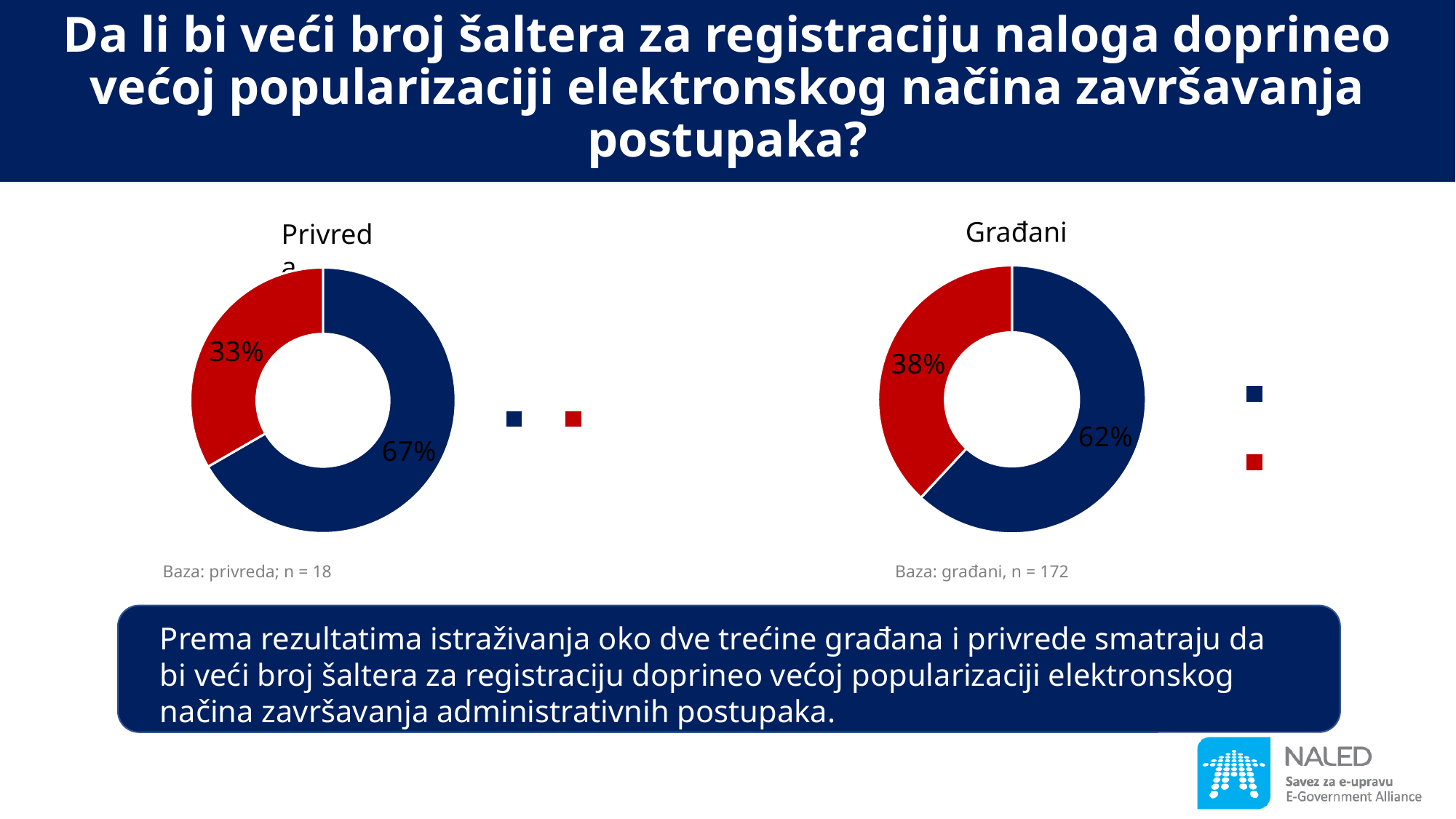
In the Privreda chart, which colour slice is the largest? dark blue In the Građani chart, what percentage does the red slice show? 38% Is the dark blue slice larger in the Privreda chart or in the Građani chart? Privreda In the Privreda chart, what percentage does the red slice show? 33% In the Građani chart, what percentage does the dark blue slice show? 62% In the Privreda chart, what is the difference between the dark blue slice and the red slice? 34 percentage points In the Privreda chart, what percentage does the dark blue slice show? 67% In the Građani chart, what is the difference between the dark blue slice and the red slice? 24 percentage points In the Građani chart, which colour slice is the smallest? red How many slices does the Privreda chart have? 2 What is the sample size (n) stated under the Građani chart? 172 What kind of chart is the Građani chart? doughnut (pie) chart